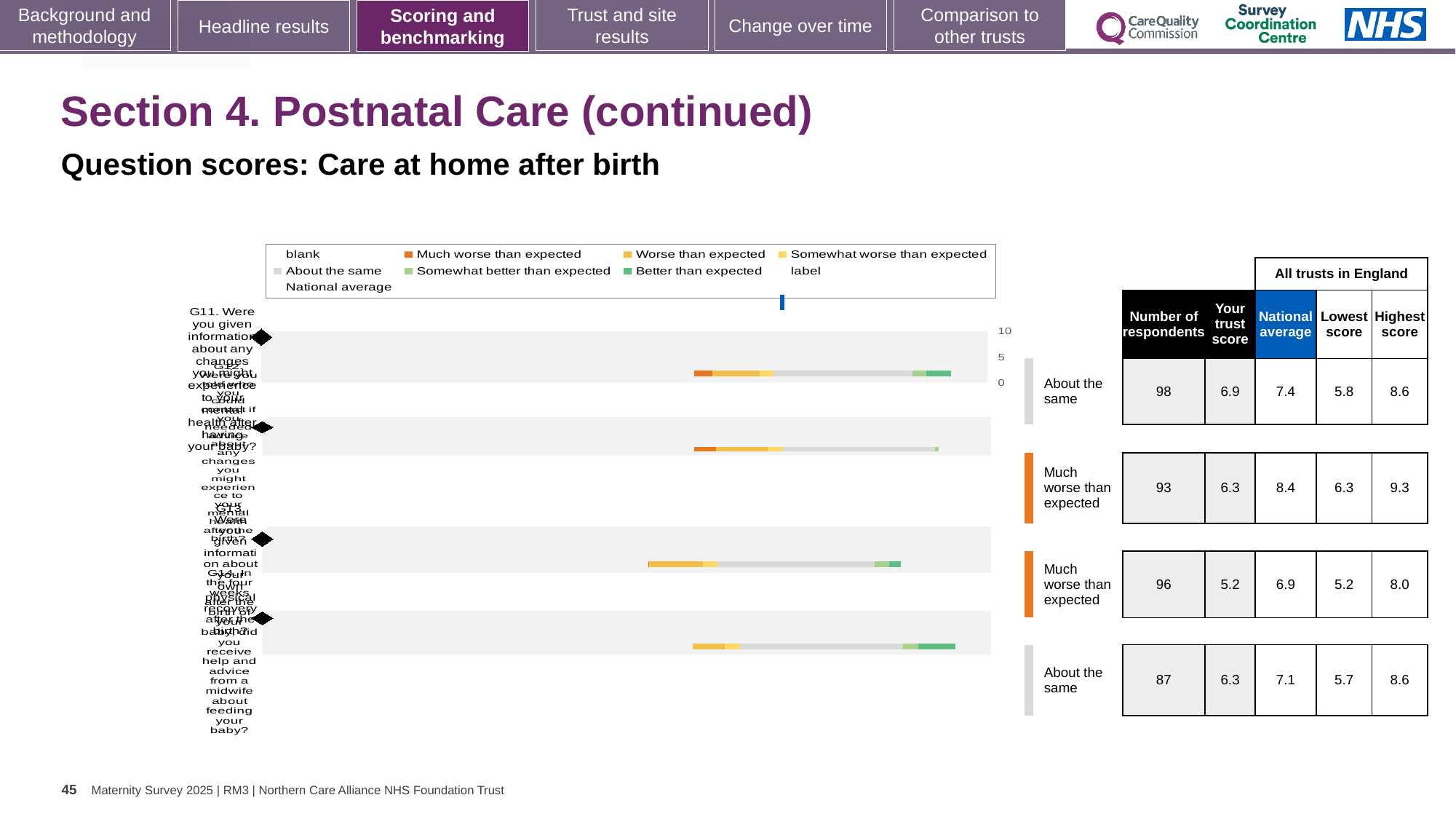
In the table on the right, what is the national average in the second row? 8.4 In the table on the right, what is the number of respondents in the first row? 98 In the table on the right, is the number of respondents larger in the first row or the fourth row? first row How many bars are plotted in the chart? 4 In the table on the right, which row has the lowest trust score? third row (5.2) In the table on the right, what is the highest score in the fourth row? 8.6 Which legend entry is shown in orange? Much worse than expected In the table on the right, which row has the largest 'Highest score' value? second row (9.3) In the table on the right, what is the trust score in the third row? 5.2 What kind of chart is shown on the slide? bar chart What is the highest value shown on the chart's numeric axis? 10 In the table on the right, what is the difference between the national average and the trust score in the first row? 0.5